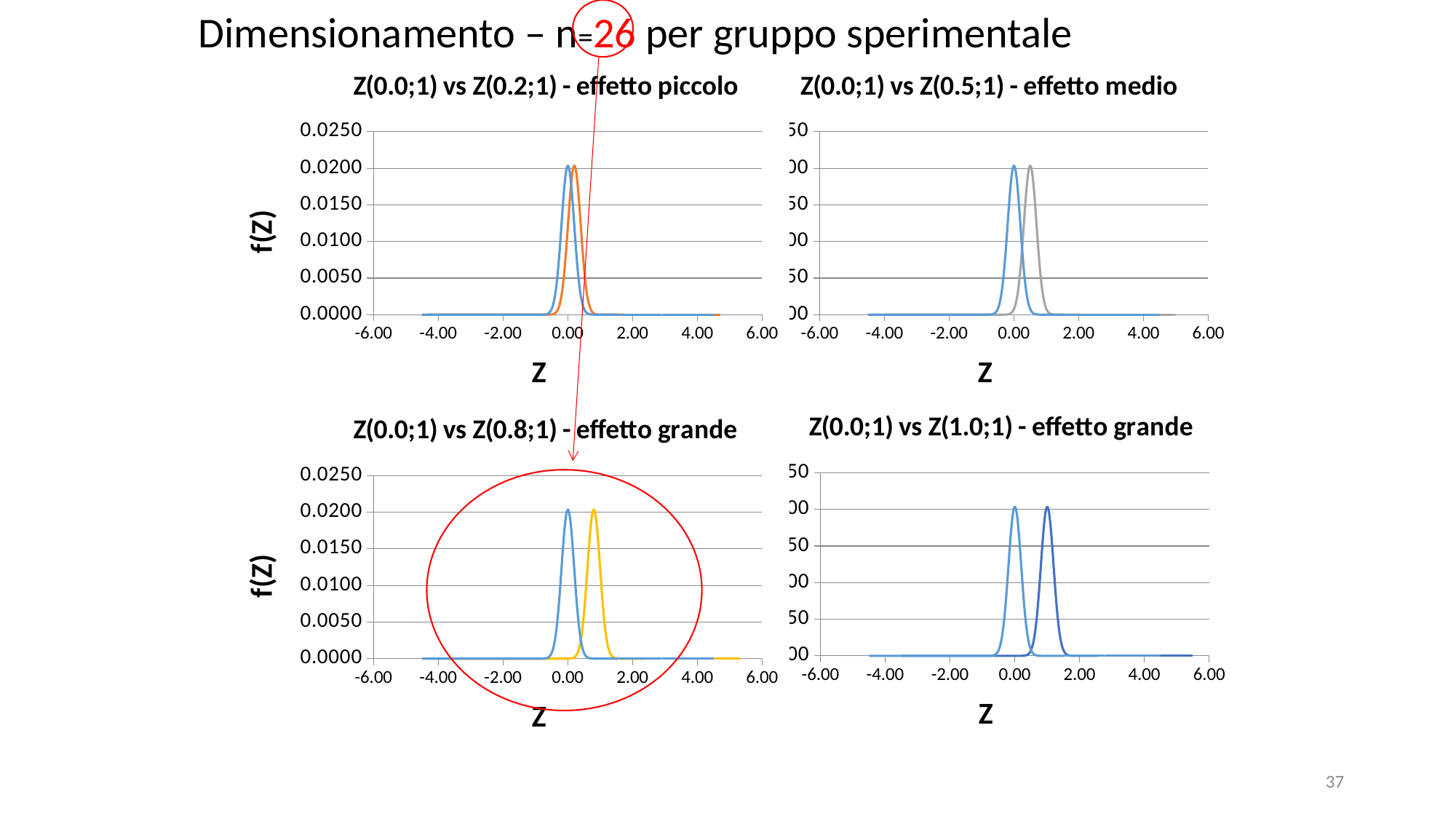
What is the highest tick value shown on the vertical axis of the 'Z(0.0;1) vs Z(0.8;1) - effetto grande' chart? 0.0250 In the 'Z(0.0;1) vs Z(0.2;1) - effetto piccolo' chart, is the peak value of the blue curve greater or less than 0.0150? greater What is the label of the vertical axis on the 'Z(0.0;1) vs Z(0.2;1) - effetto piccolo' chart? f(Z) In the 'Z(0.0;1) vs Z(0.8;1) - effetto grande' chart, is the value of the blue curve at Z = 4.00 greater or less than 0.0050? less What kind of chart is the 'Z(0.0;1) vs Z(0.2;1) - effetto piccolo' chart? line chart How many charts are shown on the slide? 4 What is the lowest tick value shown on the horizontal axis of the 'Z(0.0;1) vs Z(0.5;1) - effetto medio' chart? -6.00 How many curves are plotted in the 'Z(0.0;1) vs Z(0.8;1) - effetto grande' chart? 2 What is the title of the bottom-right chart? Z(0.0;1) vs Z(1.0;1) - effetto grande In the 'Z(0.0;1) vs Z(0.8;1) - effetto grande' chart, is the peak value of the yellow curve greater or less than 0.0250? less In the 'Z(0.0;1) vs Z(1.0;1) - effetto grande' chart, which curve peaks further to the right along the Z axis, the light blue one or the dark blue one? the dark blue one In the 'Z(0.0;1) vs Z(0.5;1) - effetto medio' chart, does the blue curve rise or fall as Z goes from 0.00 to 2.00? fall